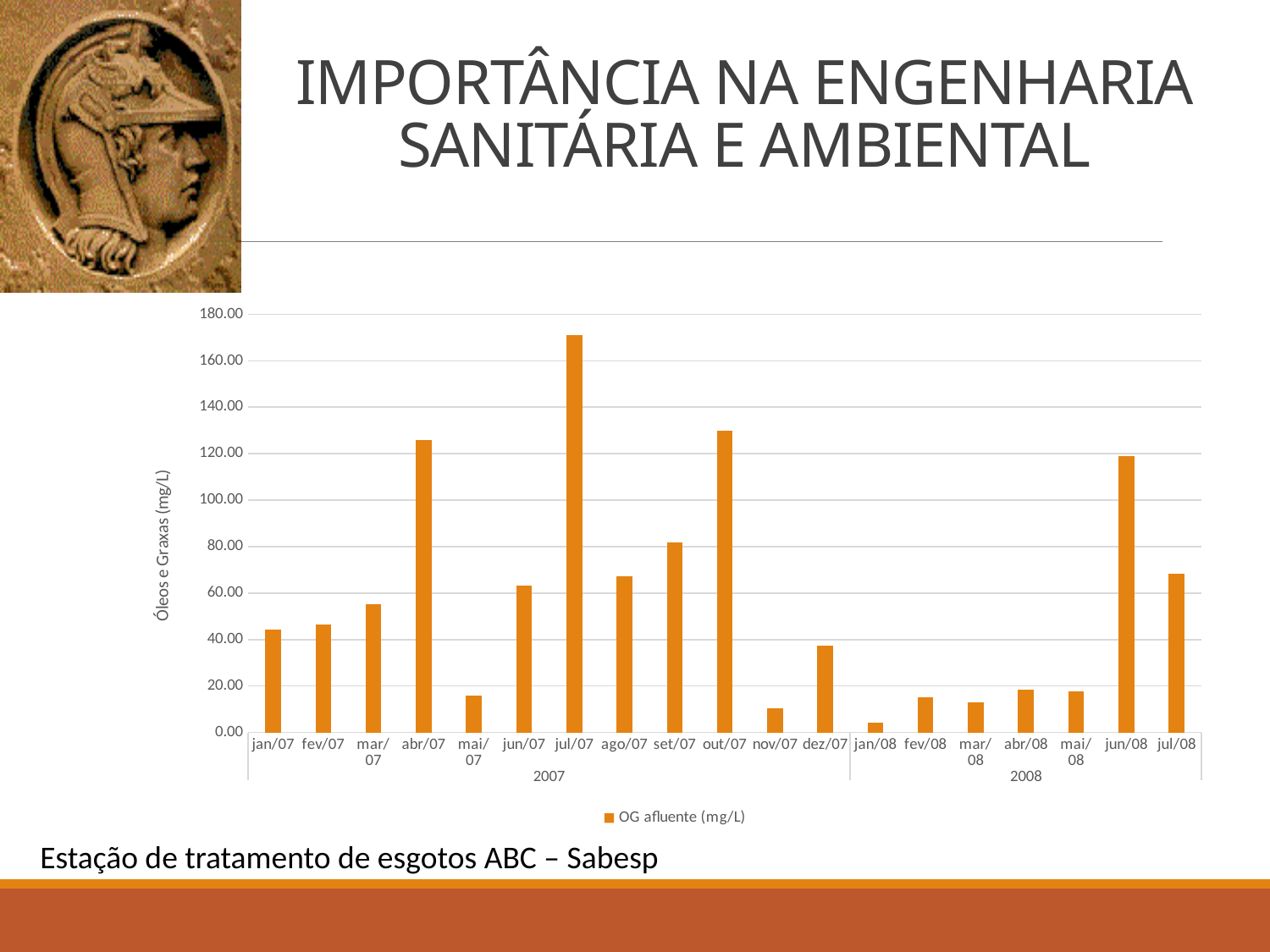
What kind of chart is shown on the slide? bar chart How many months (bars) are plotted in the chart? 19 Is the value for jul/07 greater or less than 160? greater Which is larger, the value for jun/08 or the value for jul/08? jun/08 Which month has the highest OG afluente value? jul/07 Do the values rise or fall from out/07 to jan/08? fall How many series does the legend list? 1 Is the value for mai/07 greater or less than 20? less What is the label on the vertical axis of the chart? Óleos e Graxas (mg/L) Which month has the lowest OG afluente value? jan/08 Is the value for jun/08 greater or less than 100? greater